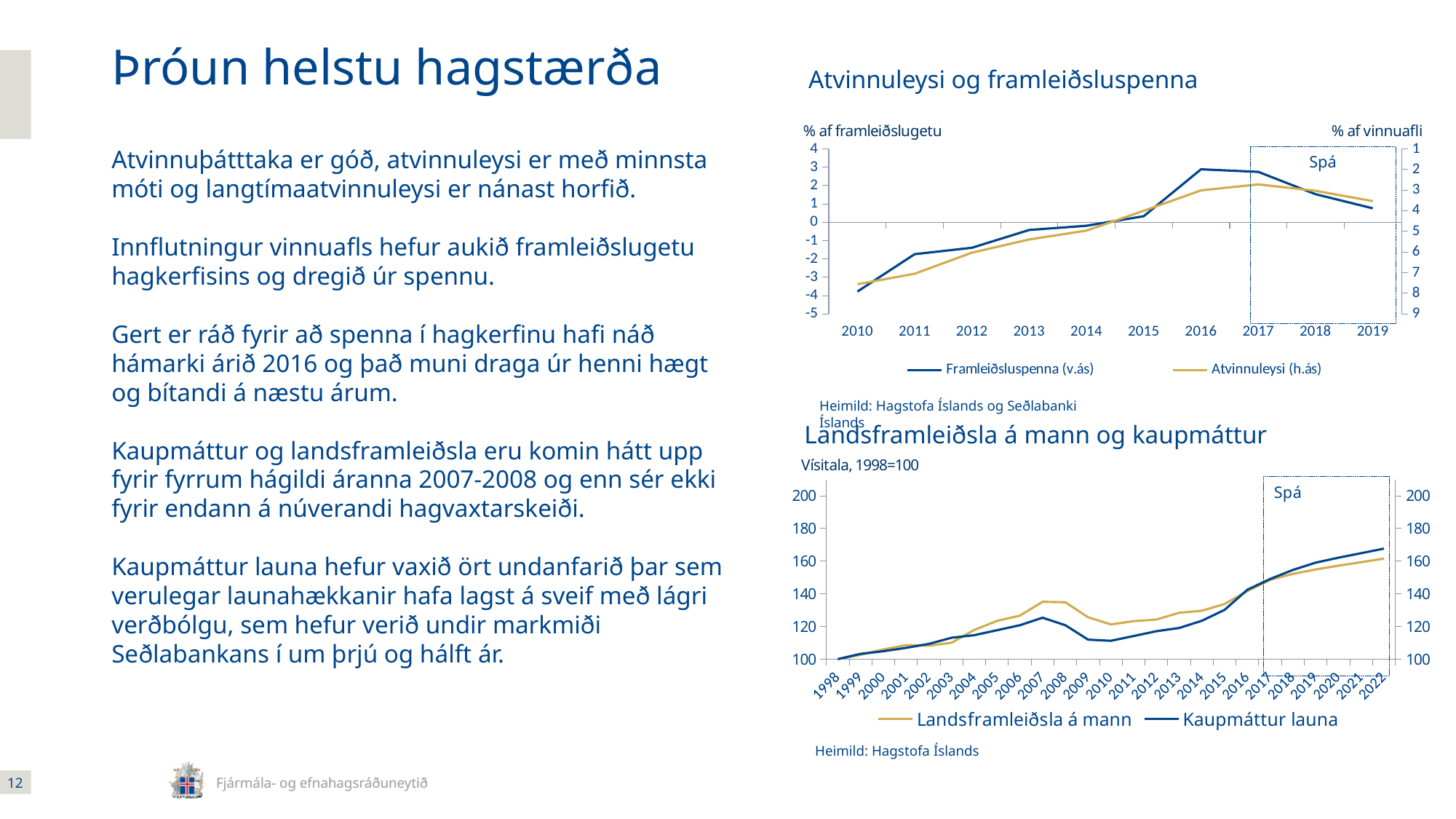
In the 'Landsframleiðsla á mann og kaupmáttur' chart, is the value of Kaupmáttur launa in 2022 greater or less than 160? greater What kind of chart is the 'Atvinnuleysi og framleiðsluspenna' chart? line chart How many years are shown on the x axis of the 'Landsframleiðsla á mann og kaupmáttur' chart? 25 In the 'Atvinnuleysi og framleiðsluspenna' chart, is the value of Framleiðsluspenna in 2010 greater or less than -3? less In the 'Landsframleiðsla á mann og kaupmáttur' chart, what is the value of Kaupmáttur launa in 1998? 100 What kind of chart is the 'Landsframleiðsla á mann og kaupmáttur' chart? line chart In the 'Atvinnuleysi og framleiðsluspenna' chart, in which year does Framleiðsluspenna reach its highest value? 2016 In the 'Atvinnuleysi og framleiðsluspenna' chart, does Framleiðsluspenna rise or fall from 2010 to 2016? rise In the 'Landsframleiðsla á mann og kaupmáttur' chart, which series is higher in 2007, Landsframleiðsla á mann or Kaupmáttur launa? Landsframleiðsla á mann In the 'Atvinnuleysi og framleiðsluspenna' chart, is the value of Framleiðsluspenna in 2016 greater or less than 2? greater How many years are shown on the x axis of the 'Atvinnuleysi og framleiðsluspenna' chart? 10 How many series does the legend of the 'Atvinnuleysi og framleiðsluspenna' chart list? 2